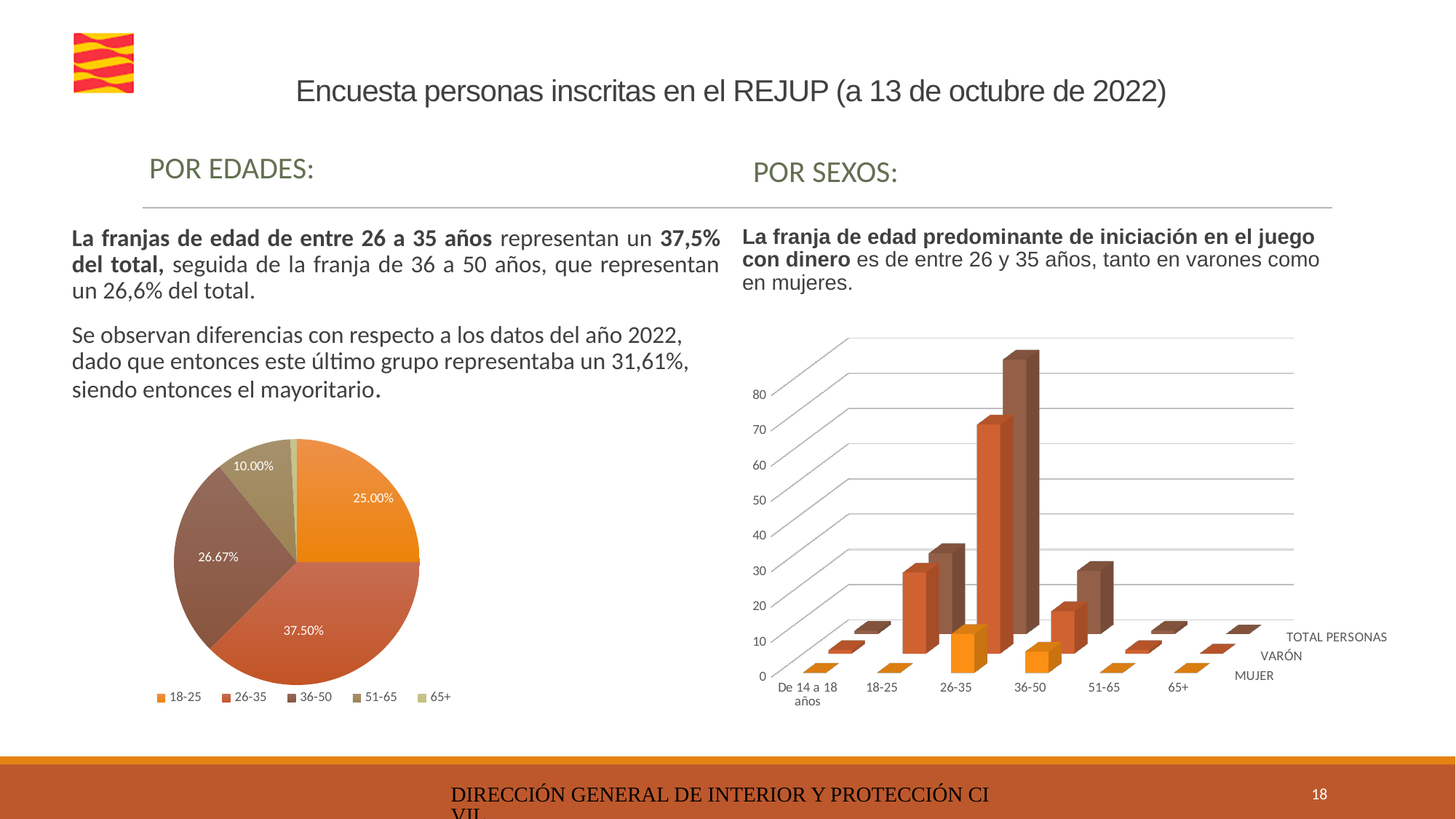
In the bar chart on the right (POR SEXOS), how many series does the legend list? 3 In the pie chart on the left (POR EDADES), what is the difference in percentage points between the 26-35 slice and the 18-25 slice? 12.50% What kind of chart is shown on the right under POR SEXOS? Bar chart In the pie chart on the left (POR EDADES), how many age groups does the legend list? 5 In the pie chart on the left (POR EDADES), what share does the 26-35 slice represent? 37.50% In the pie chart on the left (POR EDADES), which age group has the largest slice? 26-35 In the pie chart on the left (POR EDADES), what share does the 51-65 slice represent? 10.00% In the pie chart on the left (POR EDADES), what share does the 36-50 slice represent? 26.67% In the bar chart on the right (POR SEXOS), how many age categories are shown on the x axis? 6 In the bar chart on the right (POR SEXOS), is the VARÓN value for 26-35 greater or less than 50? greater In the pie chart on the left (POR EDADES), which age group has the smallest slice? 65+ In the bar chart on the right (POR SEXOS), which age category has the highest TOTAL PERSONAS bar? 26-35